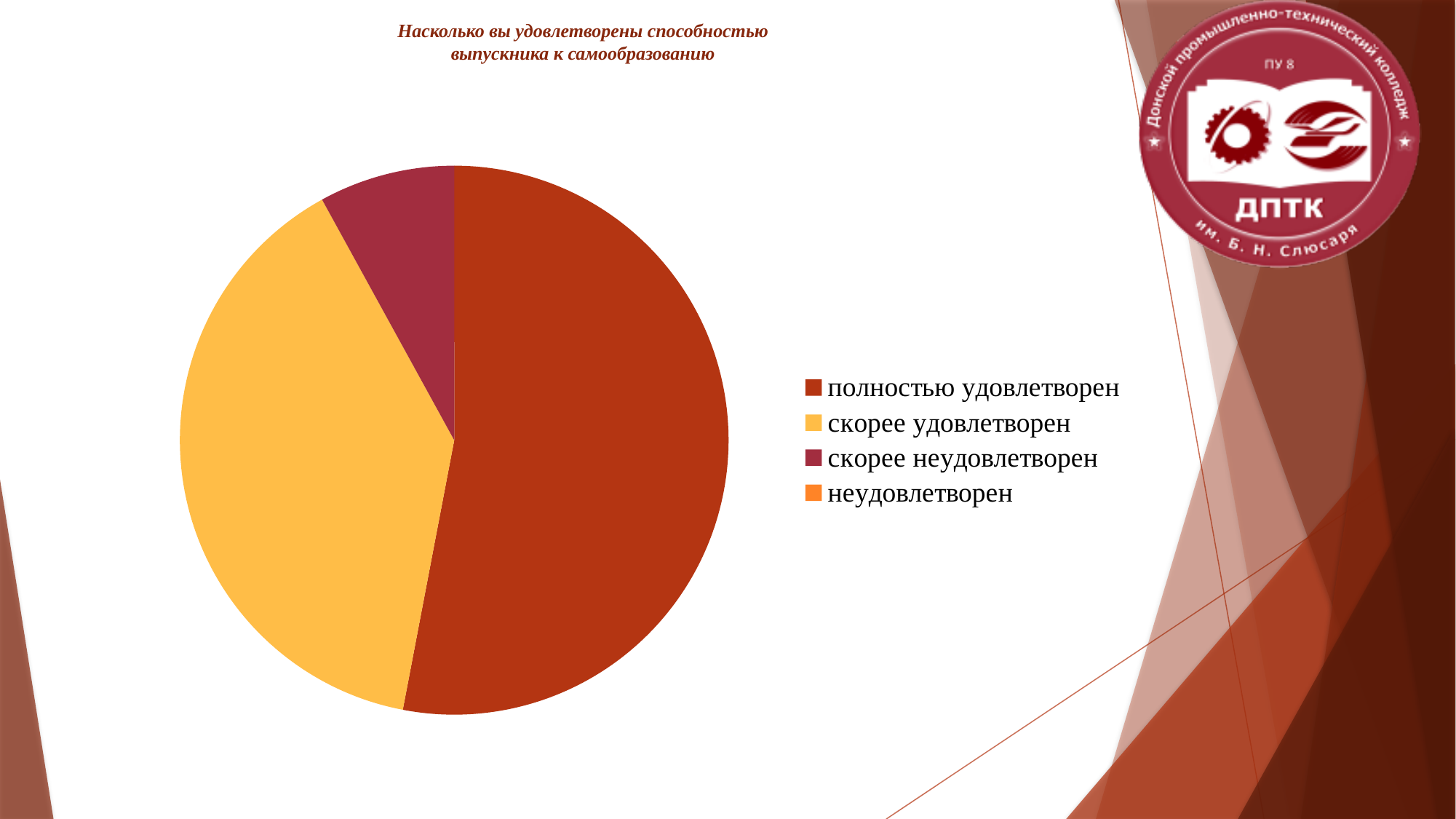
How many entries does the chart's legend list? 4 Which legend entry has no visible slice in the pie? неудовлетворен Which slice is larger: полностью удовлетворен or скорее удовлетворен? полностью удовлетворен How many slices are visible in the pie chart? 3 Does the slice for полностью удовлетворен take up more or less than half of the pie? more Which category has the largest slice of the pie? полностью удовлетворен Which slice is larger: скорее удовлетворен or скорее неудовлетворен? скорее удовлетворен What is the title of the chart? Насколько вы удовлетворены способностью выпускника к самообразованию What kind of chart is shown on the slide? pie chart Which of the visible slices is the smallest? скорее неудовлетворен